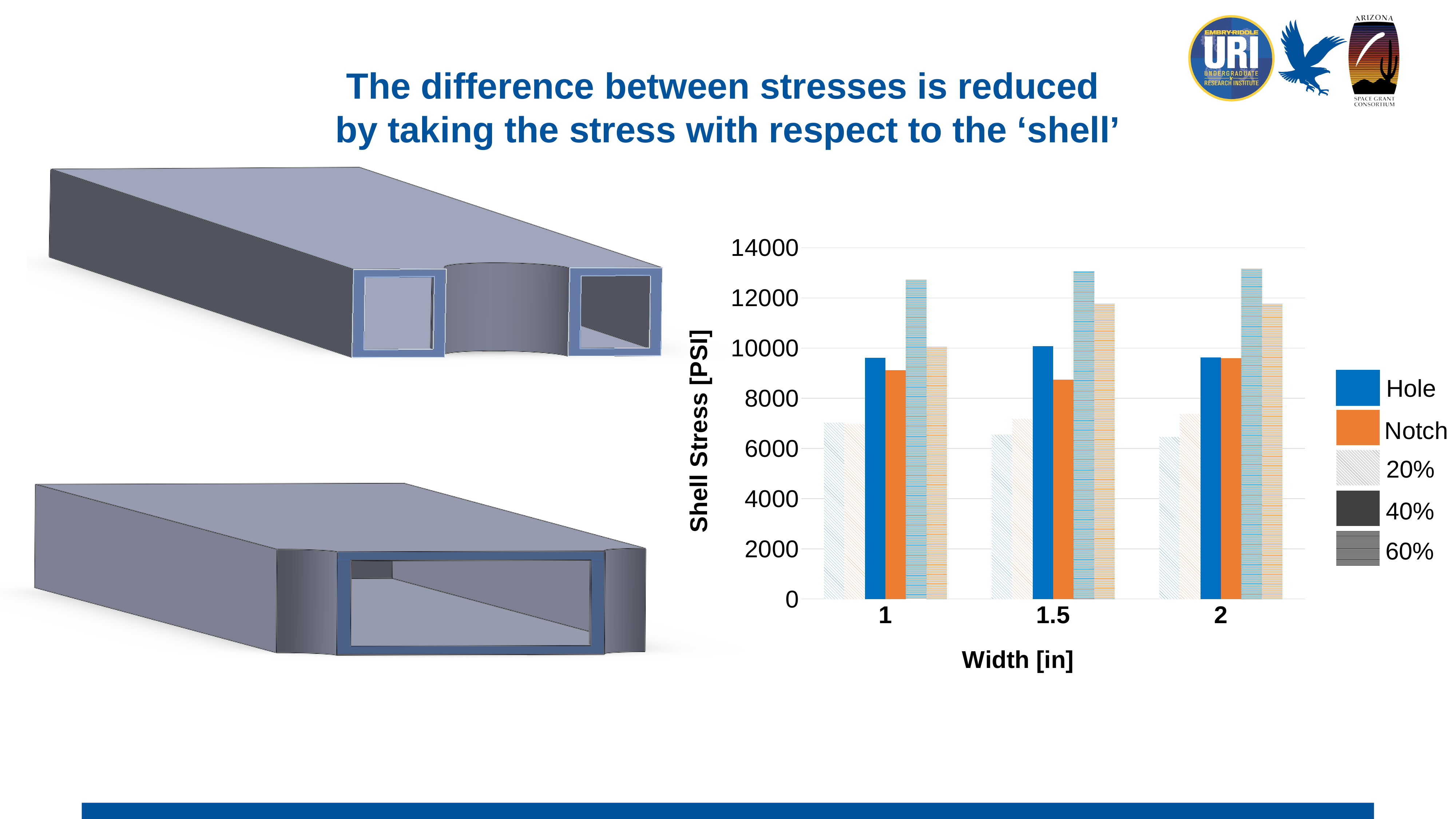
Is the value of the solid orange (Notch) bar at width 1.5 greater or less than 8000? greater At width 1.5, which is larger: the solid blue (Hole) bar or the solid orange (Notch) bar? solid blue (Hole) What kind of chart is shown on the slide? bar chart How many width categories are shown on the x axis of the chart? 3 At width 1, which is larger: the solid blue (Hole) bar or the solid orange (Notch) bar? solid blue (Hole) Is the value of the light hatched (20%) blue bar at width 1 greater or less than 8000? less What is the label of the y axis of the chart? Shell Stress [PSI] How many entries does the chart's legend list? 5 Is the value of the solid blue (Hole) bar at width 1 greater or less than 8000? greater What is the label of the x axis of the chart? Width [in]